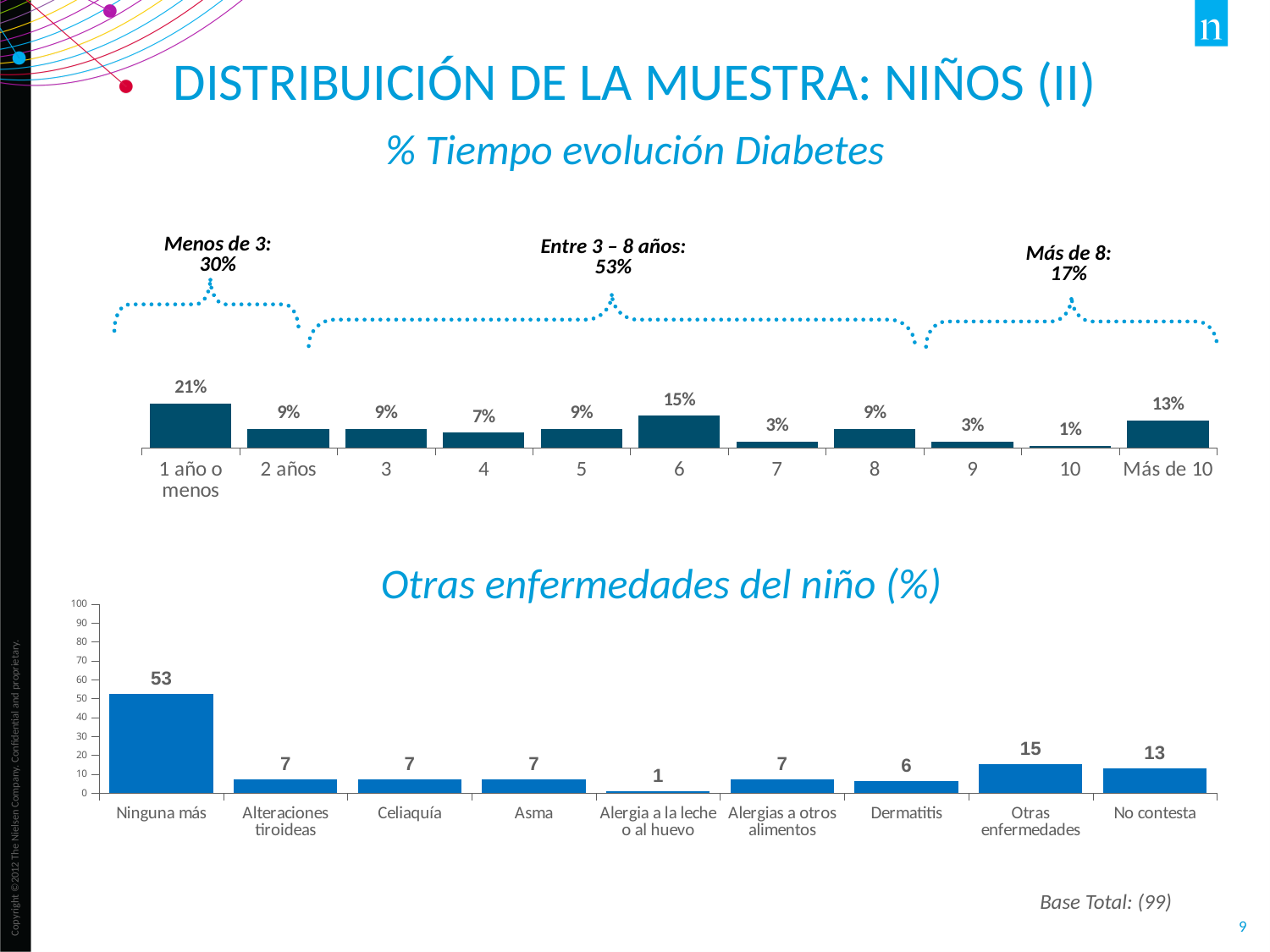
In the '% Tiempo evolución Diabetes' chart, what is the value for '1 año o menos'? 21% In the 'Otras enfermedades del niño (%)' chart, what is the value for 'Otras enfermedades'? 15 In the '% Tiempo evolución Diabetes' chart, what is the value for '6'? 15% In the 'Otras enfermedades del niño (%)' chart, which category has the lowest value? Alergia a la leche o al huevo In the 'Otras enfermedades del niño (%)' chart, what is the difference between 'Ninguna más' and 'Dermatitis'? 47 In the '% Tiempo evolución Diabetes' chart, which category has the lowest value? 10 In the 'Otras enfermedades del niño (%)' chart, which is larger, 'Otras enfermedades' or 'No contesta'? Otras enfermedades What kind of chart is the 'Otras enfermedades del niño (%)' chart? Bar chart In the '% Tiempo evolución Diabetes' chart, what is the difference between the values for '1 año o menos' and 'Más de 10'? 8% In the '% Tiempo evolución Diabetes' chart, which category has the highest value? 1 año o menos In the 'Otras enfermedades del niño (%)' chart, what is the value for 'Ninguna más'? 53 In the '% Tiempo evolución Diabetes' chart, how many categories are shown on the x axis? 11